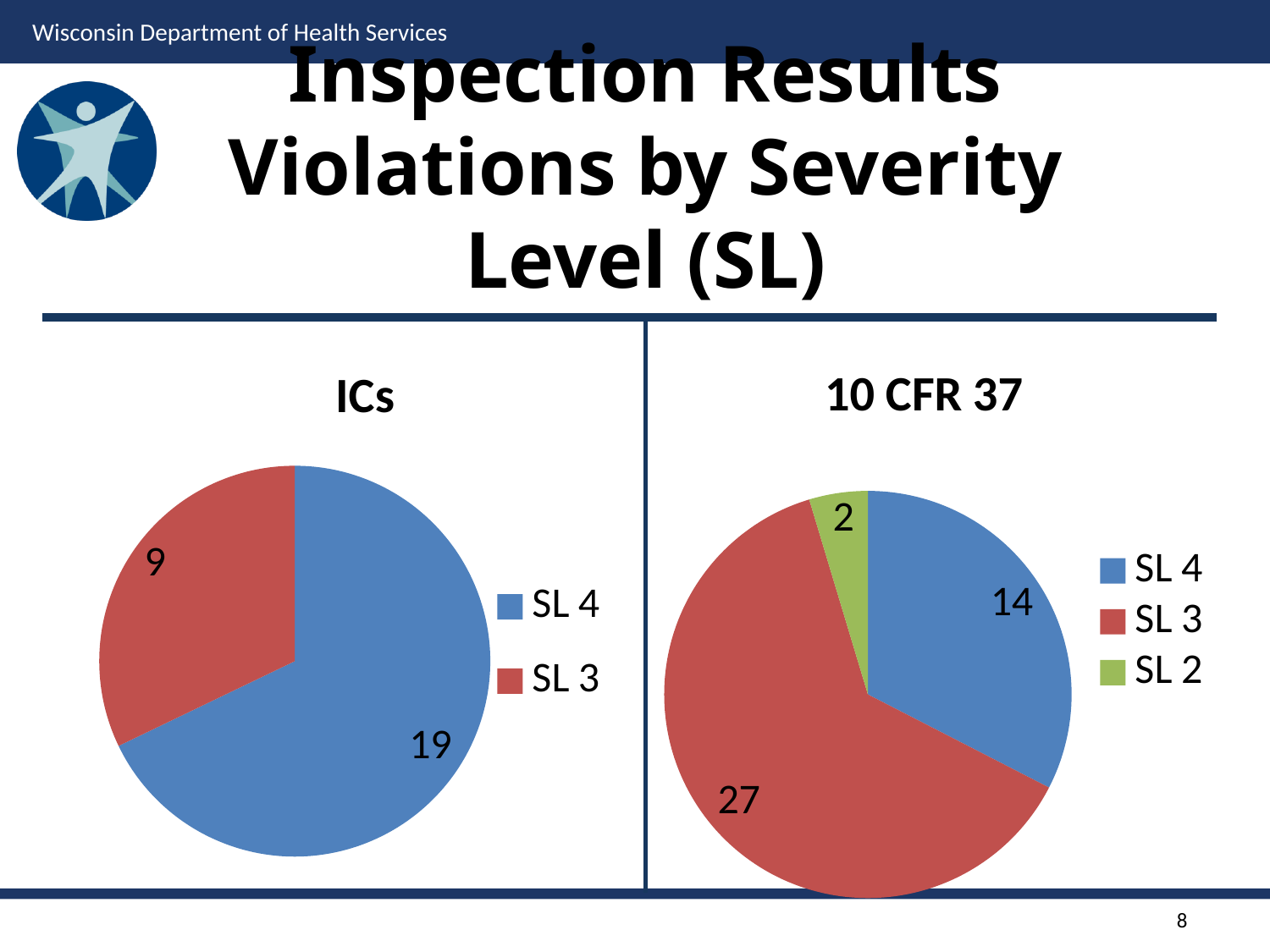
In the 10 CFR 37 chart, which severity level has the smallest slice? SL 2 In the 10 CFR 37 chart, which severity level has the largest slice? SL 3 In the 10 CFR 37 chart, what is the value for SL 2? 2 In the ICs chart, what is the total of all slices? 28 How many slices does the 10 CFR 37 pie chart have? 3 In the 10 CFR 37 chart, what is the value for SL 3? 27 In the ICs chart, what is the difference between the SL 4 and SL 3 values? 10 In the ICs chart, what is the value for SL 4? 19 Which is larger in the ICs chart, SL 4 or SL 3? SL 4 In the 10 CFR 37 chart, what is the difference between the SL 3 and SL 4 values? 13 In the ICs chart, what is the value for SL 3? 9 What type of chart is the ICs chart? Pie chart